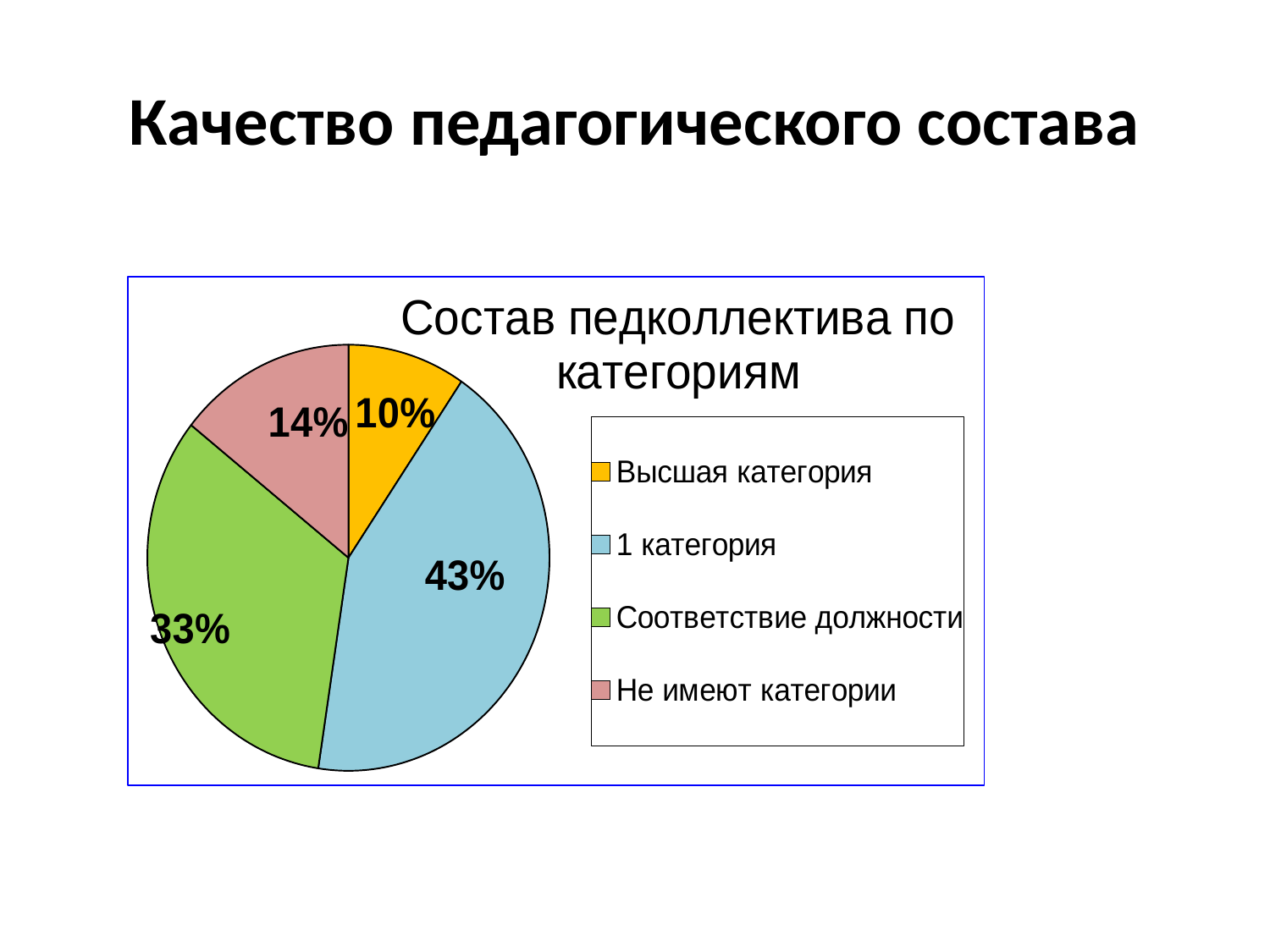
Which category has the smallest slice of the pie? Высшая категория Which is larger: the share for "Не имеют категории" or the share for "Высшая категория"? Не имеют категории What is the title of the chart? Состав педколлектива по категориям What share of the pie does "1 категория" have? 43% How many categories does the pie chart show? 4 What share of the pie does "Высшая категория" have? 10% Which category has the largest slice of the pie? 1 категория What is the difference in percentage points between "1 категория" and "Соответствие должности"? 10 What colour is the slice for "Соответствие должности"? green What share of the pie does "Соответствие должности" have? 33% What kind of chart is shown on the slide? pie chart